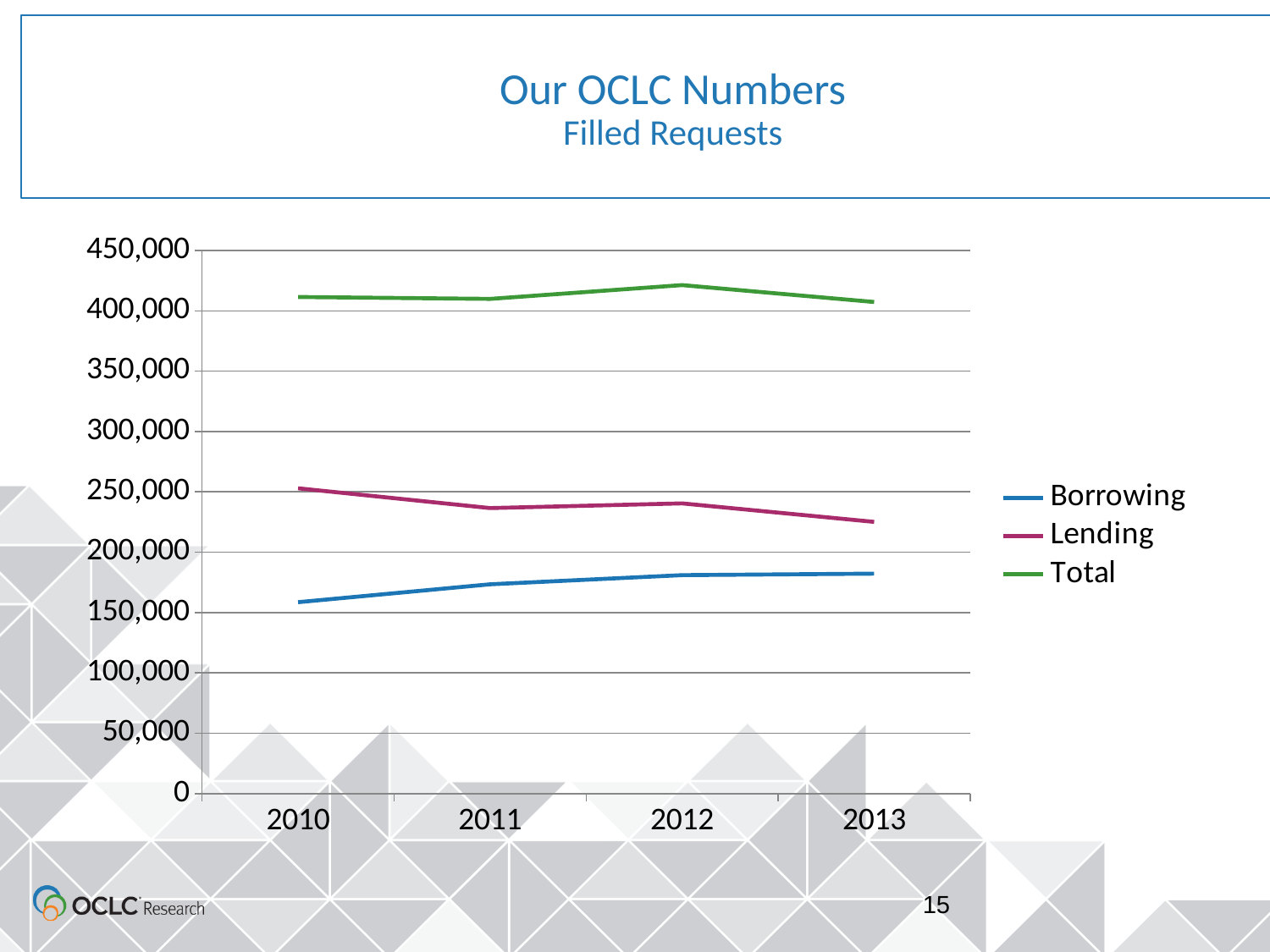
In which year is Borrowing lowest? 2010 Does the Borrowing line rise or fall from 2010 to 2013? rise Does the Lending line rise or fall from 2010 to 2013? fall What colour is the Total line in the legend? green How many series does the legend list? 3 In which year is Lending highest? 2010 What kind of chart is shown on the slide? line chart Is the value for Total in 2012 greater or less than 400,000? greater Is the value for Lending in 2013 greater or less than 250,000? less Is the value for Borrowing in 2010 greater or less than 200,000? less In 2011, which is larger, Lending or Borrowing? Lending How many years are plotted along the x axis? 4